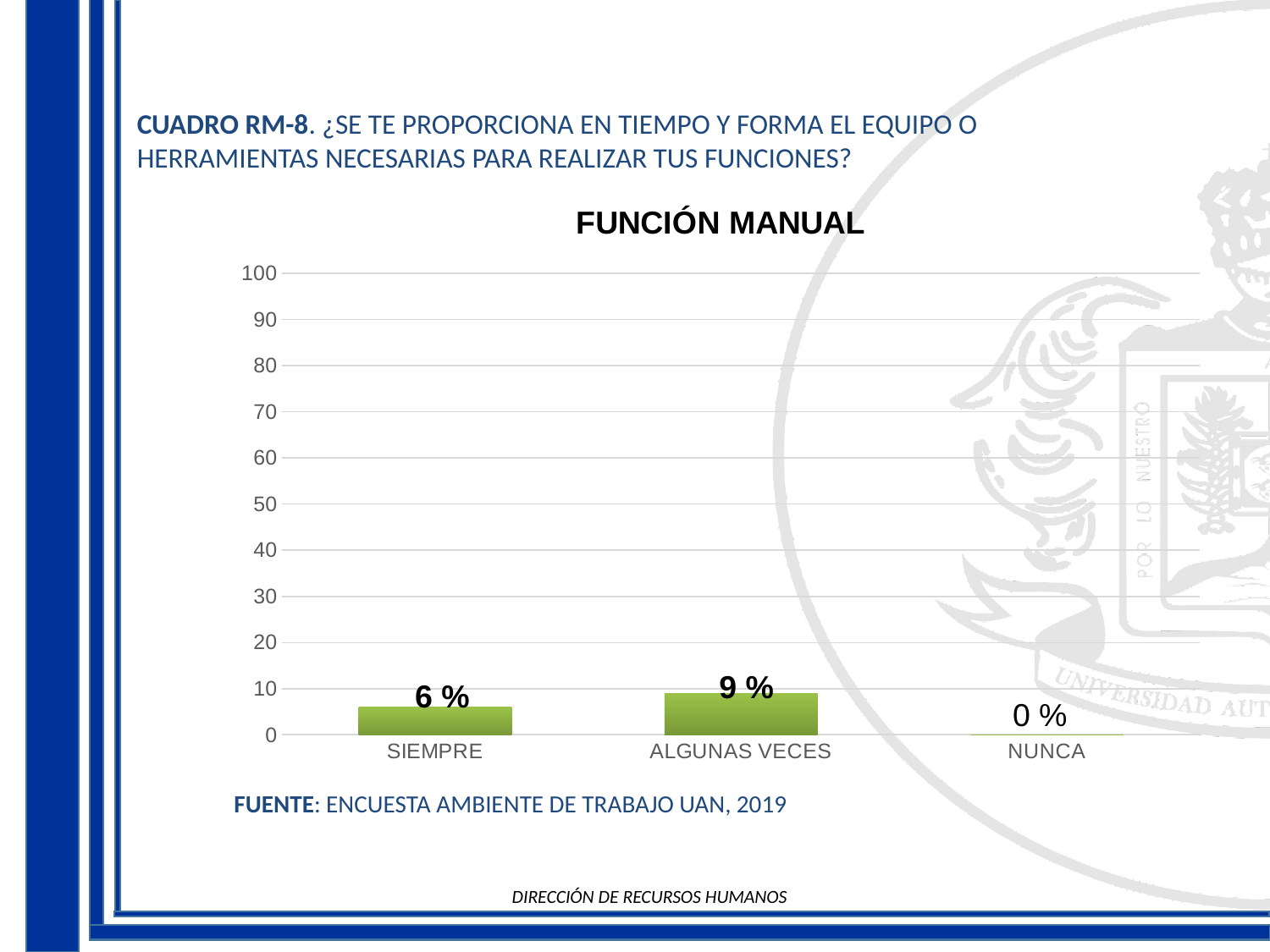
What is the highest value shown on the vertical axis? 100 What is the value for ALGUNAS VECES? 9 % What is the value for SIEMPRE? 6 % Is the value for ALGUNAS VECES greater or less than 10? less What is the difference between the values for ALGUNAS VECES and SIEMPRE? 3 % How many categories are shown on the x axis? 3 What is the title of the chart? FUNCIÓN MANUAL What kind of chart is shown? bar chart Which is larger, the value for SIEMPRE or the value for ALGUNAS VECES? ALGUNAS VECES Which category has the highest value? ALGUNAS VECES Which category has the lowest value? NUNCA What is the value for NUNCA? 0 %